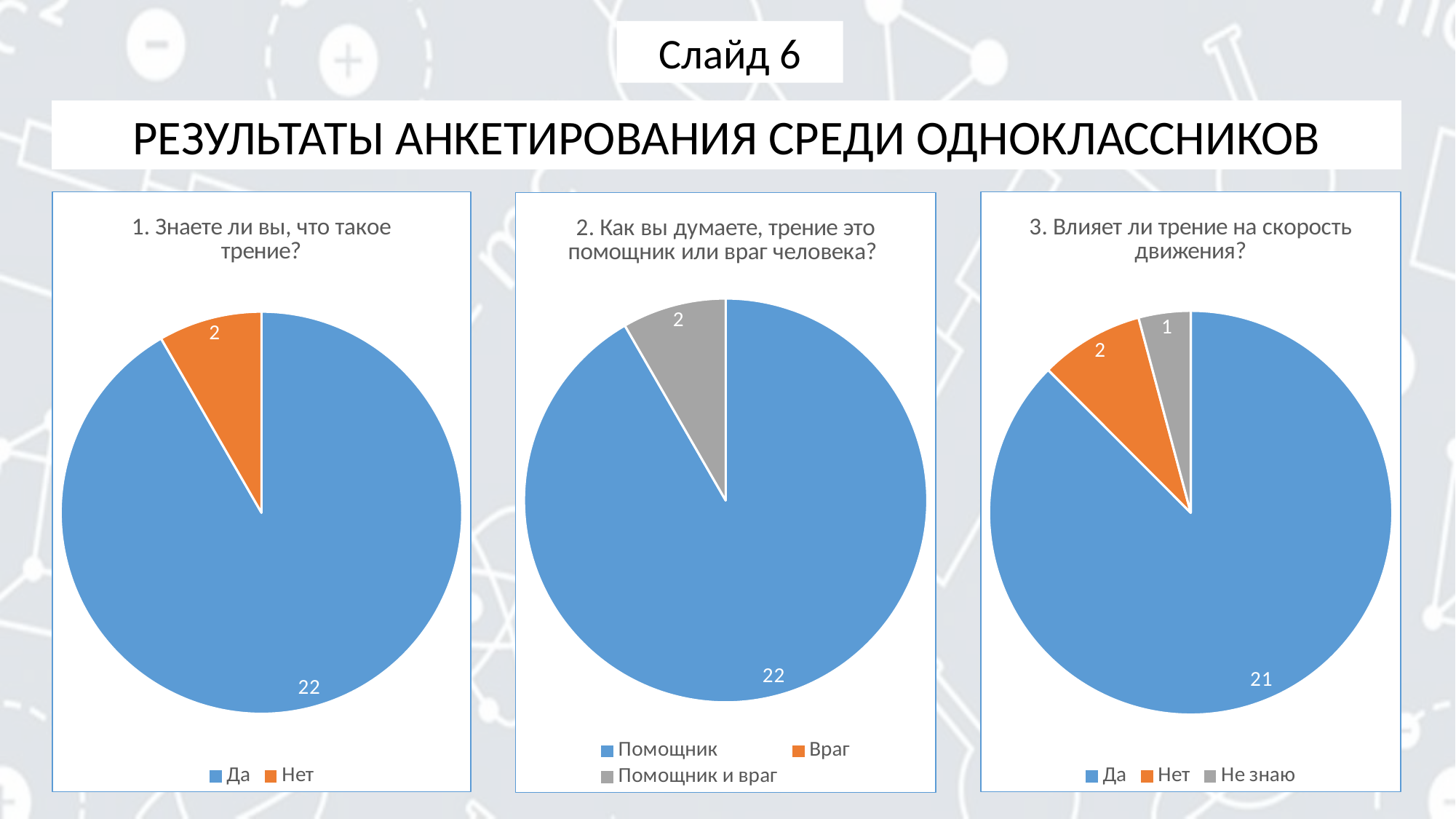
On the chart titled "3. Влияет ли трение на скорость движения?", which category has the smallest value? Не знаю On the chart titled "2. Как вы думаете, трение это помощник или враг человека?", what is the value for Помощник и враг? 2 On the chart titled "2. Как вы думаете, трение это помощник или враг человека?", what is the value for Помощник? 22 On the chart titled "3. Влияет ли трение на скорость движения?", what is the value for Да? 21 On the chart titled "3. Влияет ли трение на скорость движения?", how many categories are shown? 3 On the chart titled "3. Влияет ли трение на скорость движения?", what is the value for Не знаю? 1 On the chart titled "1. Знаете ли вы, что такое трение?", what is the value for Нет? 2 On the chart titled "2. Как вы думаете, трение это помощник или враг человека?", how many entries does the legend list? 3 On the chart titled "1. Знаете ли вы, что такое трение?", what is the value for Да? 22 What type of chart is the chart titled "1. Знаете ли вы, что такое трение?"? Pie chart On the chart titled "3. Влияет ли трение на скорость движения?", which is larger, Нет or Не знаю? Нет On the chart titled "1. Знаете ли вы, что такое трение?", what is the difference between the Да and Нет values? 20